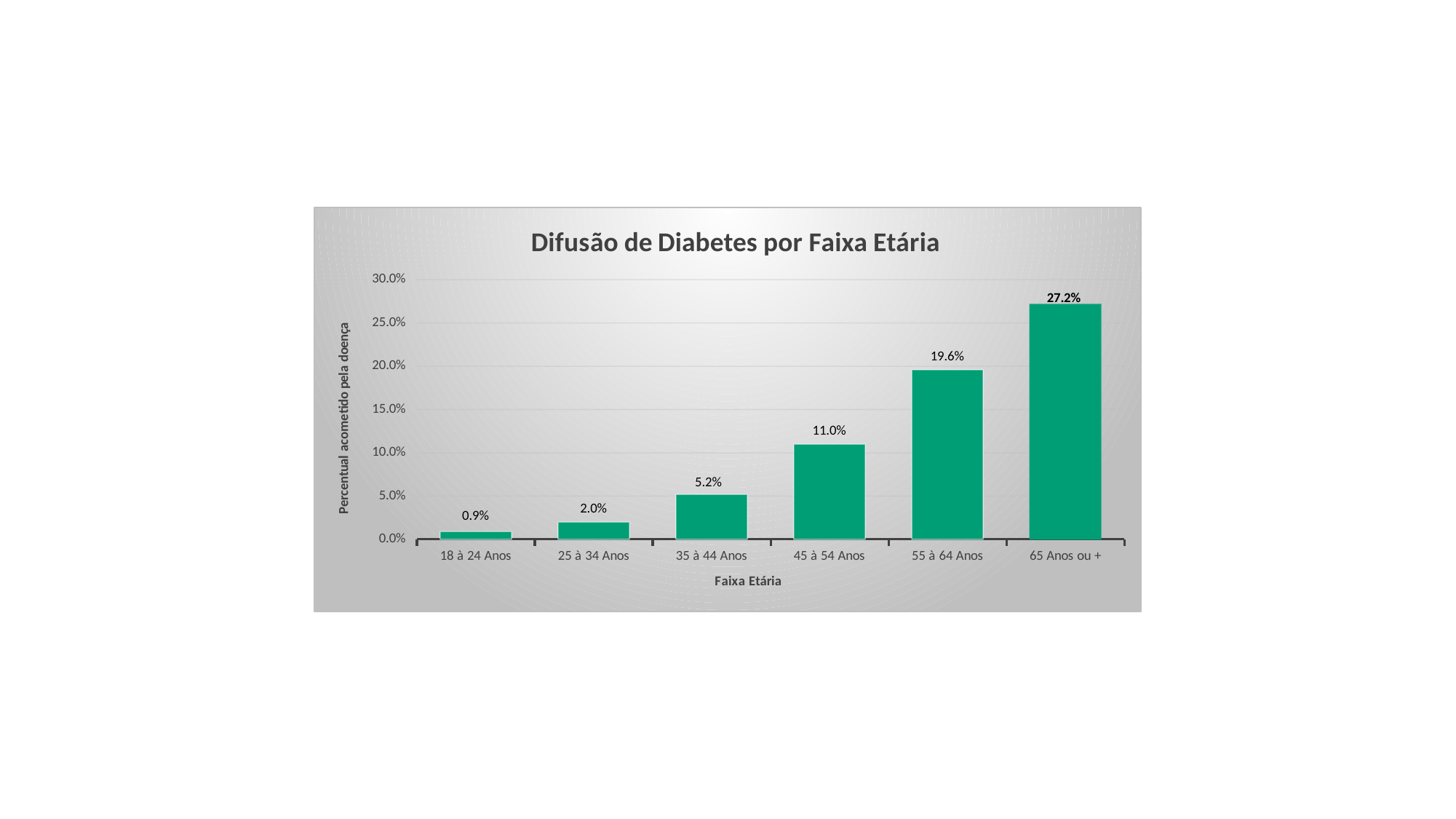
What is the value for the 45 à 54 Anos age group? 11.0% How many age groups are shown on the chart? 6 What is the value for the 18 à 24 Anos age group? 0.9% What is the difference between the values for 35 à 44 Anos and 25 à 34 Anos? 3.2% Which age group has the highest percentage? 65 Anos ou + What kind of chart is shown on the slide? Bar chart What is the difference between the values for 65 Anos ou + and 55 à 64 Anos? 7.6% Do the values rise or fall as the age groups move from left to right along the x axis? Rise Which is larger, the value for 45 à 54 Anos or the value for 35 à 44 Anos? 45 à 54 Anos Is the value for 55 à 64 Anos greater or less than 15.0%? greater What is the value for the 55 à 64 Anos age group? 19.6% Which age group has the lowest percentage? 18 à 24 Anos